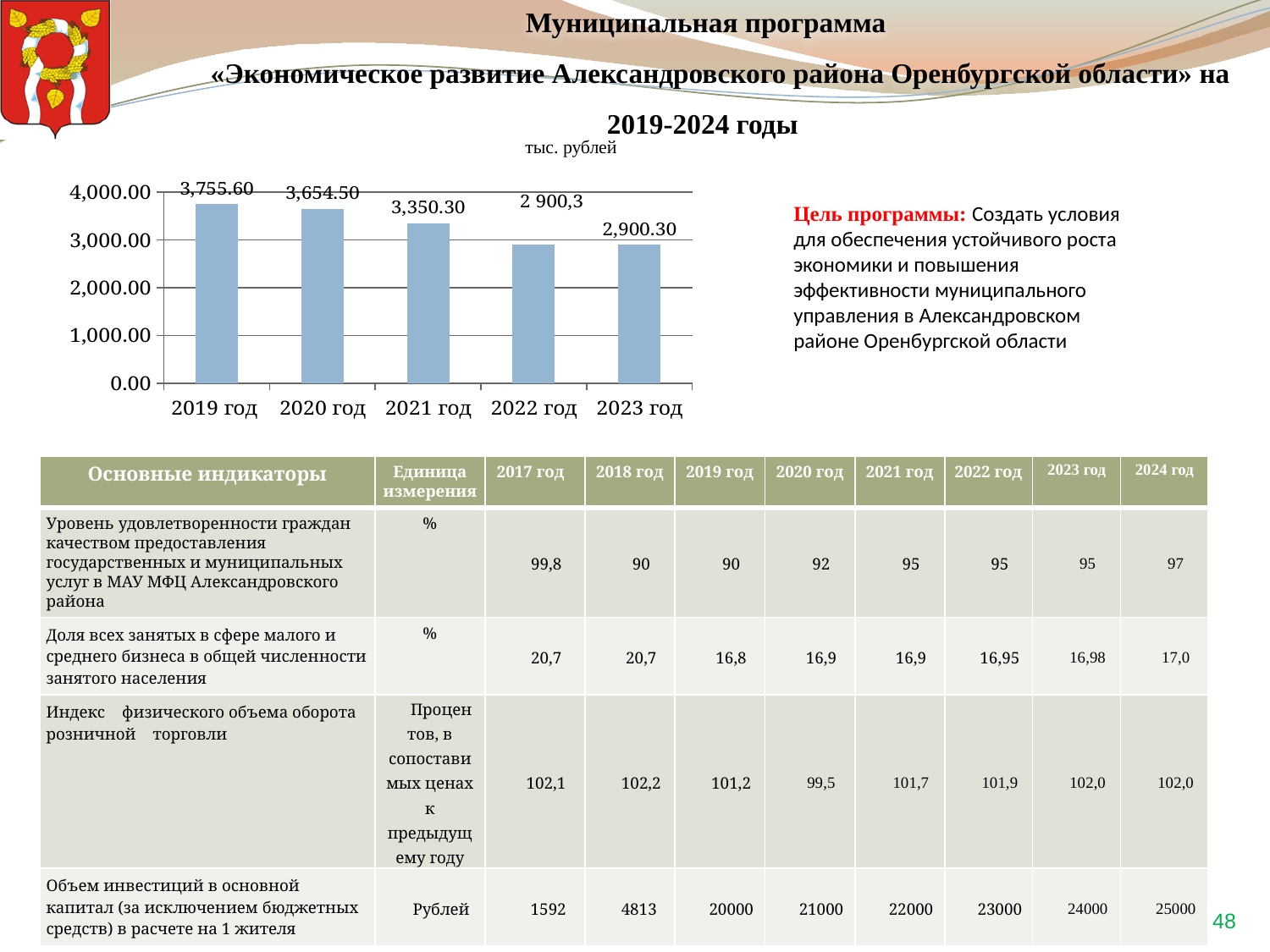
What is the difference between the values for 2019 год and 2020 год in the bar chart? 101.10 What is the value for 2019 год in the bar chart? 3,755.60 What is the value for 2023 год in the bar chart? 2,900.30 How many years are shown on the x axis of the bar chart? 5 What is the difference between the values for 2019 год and 2021 год in the bar chart? 405.30 Which is larger in the bar chart, the value for 2020 год or the value for 2021 год? 2020 год What is the value for 2021 год in the bar chart? 3,350.30 What kind of chart is shown on the slide? bar chart Is the value for 2021 год in the bar chart greater or less than 3,000.00? greater Do the values in the bar chart rise or fall from 2019 год to 2023 год? fall Which year has the highest value in the bar chart? 2019 год What is the value for 2020 год in the bar chart? 3,654.50